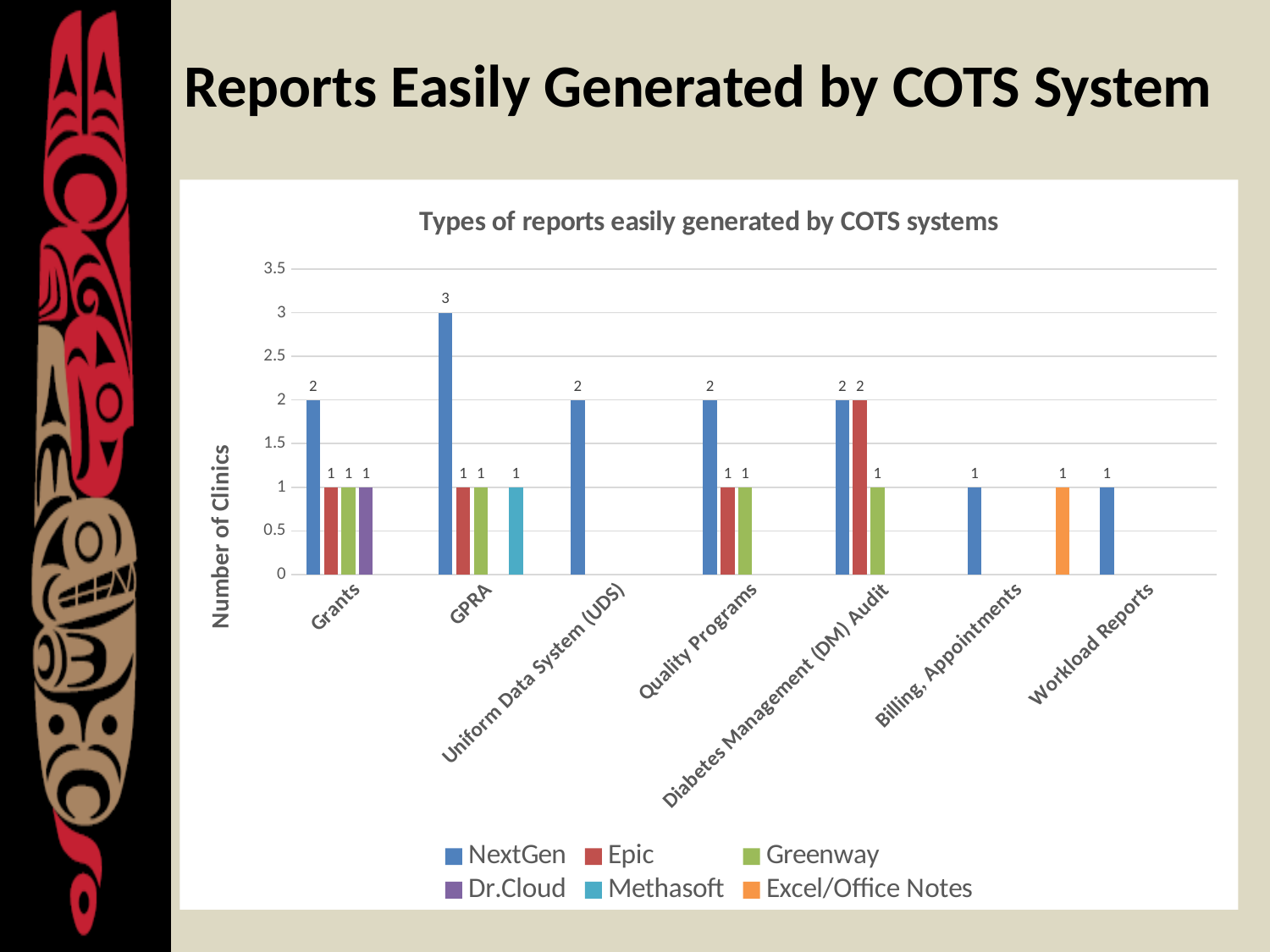
Which series has a value in the Billing, Appointments category besides NextGen? Excel/Office Notes What is the value for NextGen in the GPRA category? 3 Which is larger in the Quality Programs category: the NextGen value or the Greenway value? NextGen What is the title of the chart? Types of reports easily generated by COTS systems What is the value for Epic in the Diabetes Management (DM) Audit category? 2 How many report categories are shown on the x axis? 7 What is the difference between the NextGen value and the Epic value in the Grants category? 1 In which category does NextGen have its highest value? GPRA What is the value for Methasoft in the GPRA category? 1 What is the value for Dr.Cloud in the Grants category? 1 How many series does the legend list? 6 What type of chart is shown on the slide? bar chart